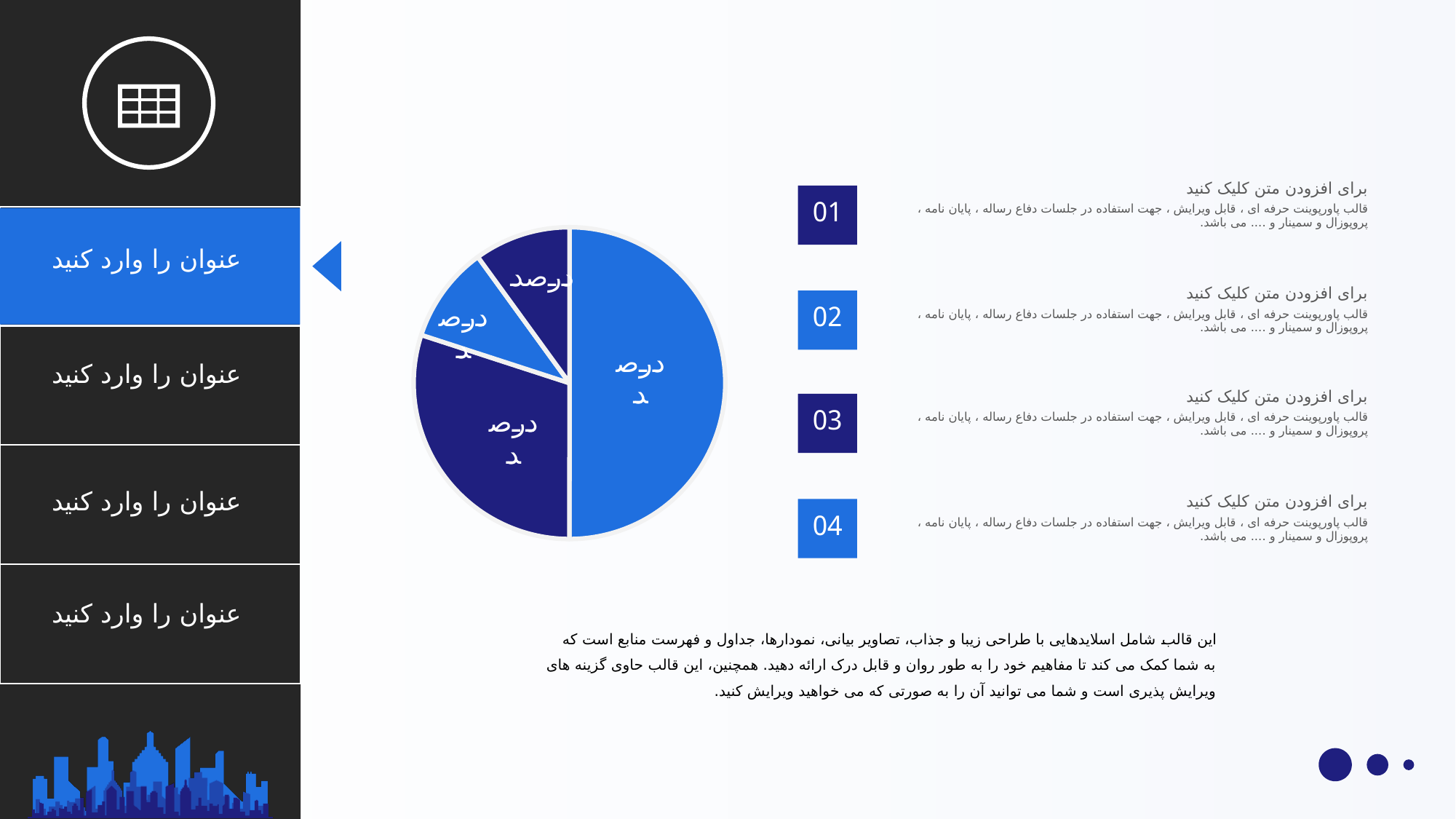
How many slices does the pie chart have? 4 What kind of chart is shown on the slide? pie chart What text label appears on each slice of the pie chart? درصد Which slice of the pie chart is the largest? the light blue slice on the right Which is larger: the light blue slice on the right or the dark blue slice at the bottom left? the light blue slice on the right Does the pie chart have a legend? No